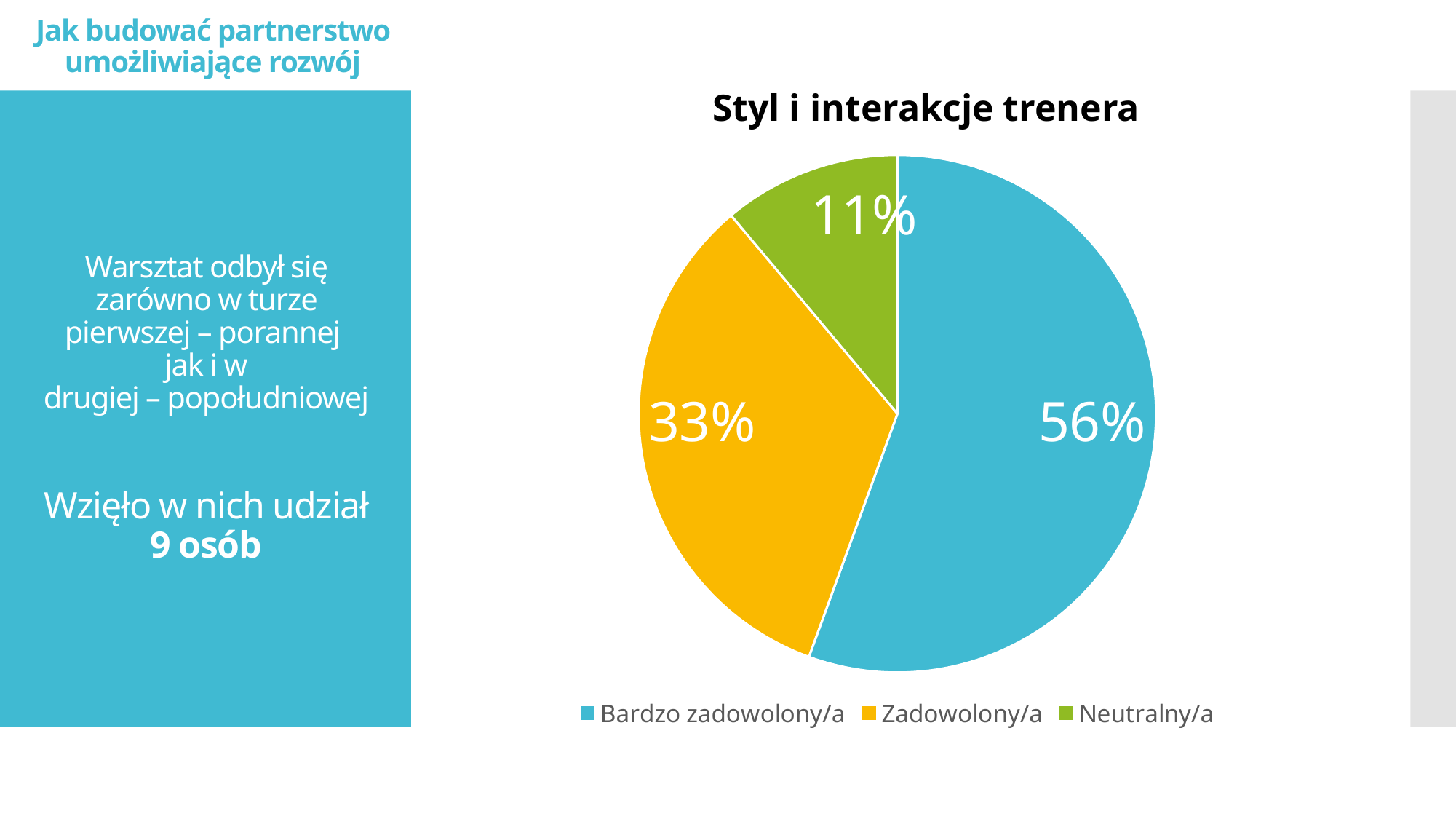
Which category has the smallest slice of the pie? Neutralny/a What colour is the Neutralny/a slice? green How many categories does the legend list? 3 What share of the pie is labelled Neutralny/a? 11% What share of the pie is labelled Zadowolony/a? 33% What share of the pie is labelled Bardzo zadowolony/a? 56% Which is larger, the Zadowolony/a slice or the Neutralny/a slice? Zadowolony/a What is the difference in percentage points between the Zadowolony/a and Neutralny/a slices? 22 What kind of chart is shown on the slide? pie chart What is the title of the chart? Styl i interakcje trenera What is the difference in percentage points between the Bardzo zadowolony/a and Zadowolony/a slices? 23 Which category has the largest slice of the pie? Bardzo zadowolony/a